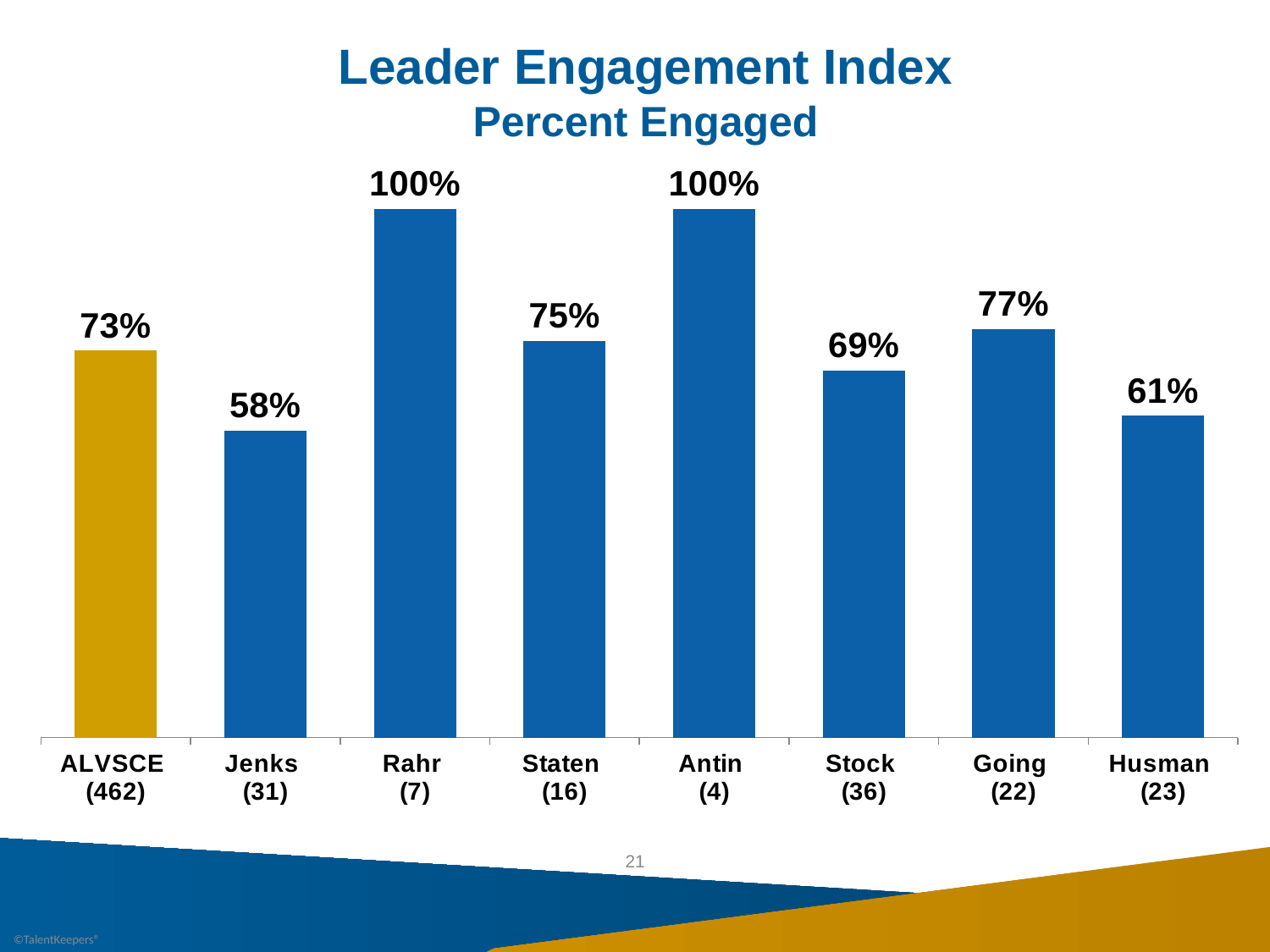
What is the difference in percent engaged between Going and Staten? 2% How many categories are shown on the chart? 8 Which categories share the highest percent engaged? Rahr and Antin Which has a higher percent engaged, Stock or Going? Going Which category has the lowest percent engaged? Jenks What kind of chart is shown on the slide? Bar chart What is the percent engaged for Stock? 69% What is the percent engaged for ALVSCE? 73% What is the difference in percent engaged between Rahr and Jenks? 42% Which bar is coloured differently (gold) from the others? ALVSCE What is the percent engaged for Husman? 61% What is the percent engaged for Jenks? 58%